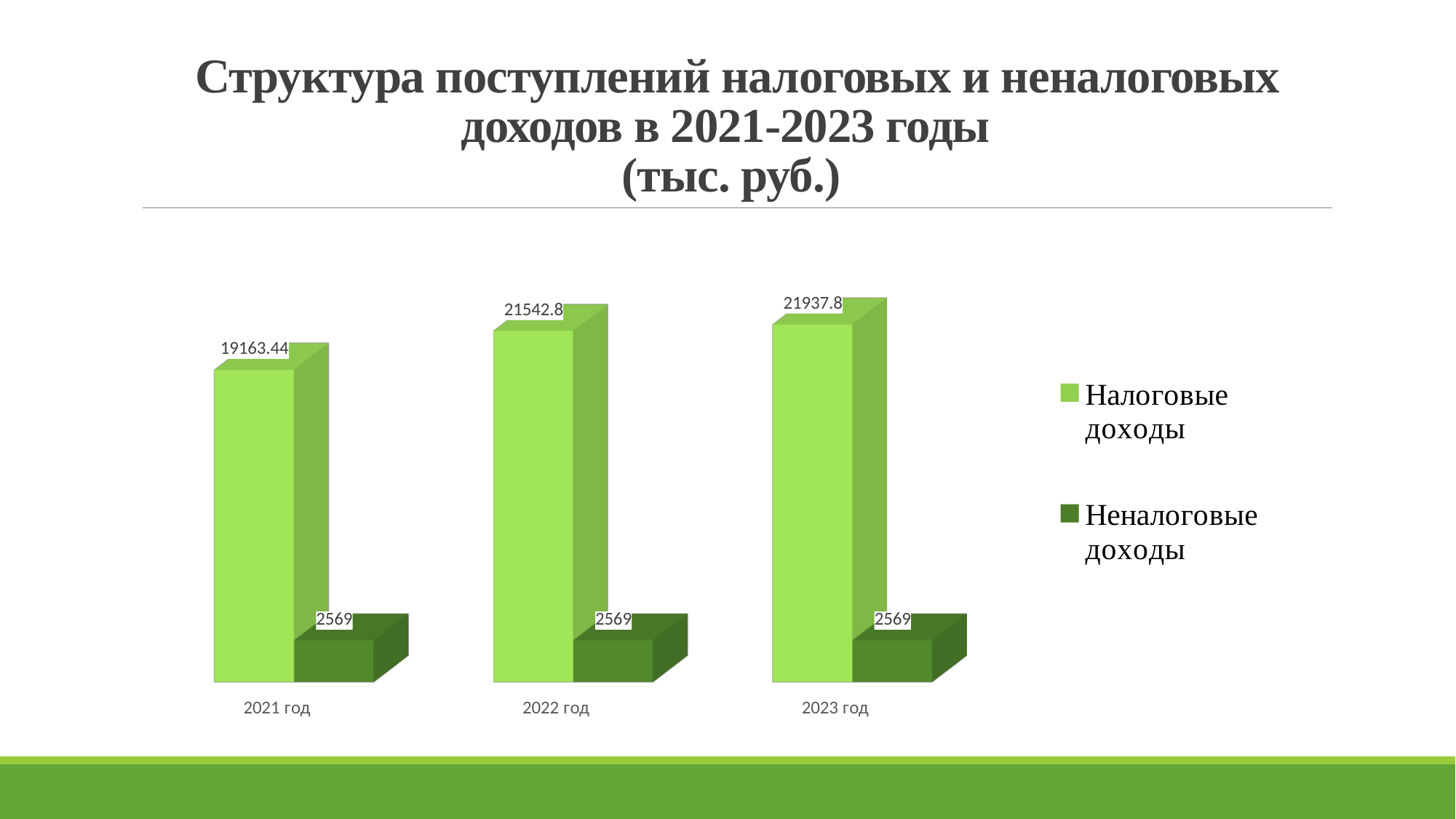
What is the value of Налоговые доходы for 2021 год? 19163.44 What is the difference between Налоговые доходы and Неналоговые доходы in 2023 год? 19368.8 Does Налоговые доходы rise or fall from 2021 год to 2023 год? rise Which is larger in 2022 год: Налоговые доходы or Неналоговые доходы? Налоговые доходы How many years are shown on the x axis? 3 In which year is Налоговые доходы the highest? 2023 год What is the difference between Налоговые доходы in 2022 год and 2021 год? 2379.36 In which year is Налоговые доходы the lowest? 2021 год What is the value of Налоговые доходы for 2023 год? 21937.8 What is the value of Налоговые доходы for 2022 год? 21542.8 What is the value of Неналоговые доходы for 2023 год? 2569 How many series does the legend list? 2